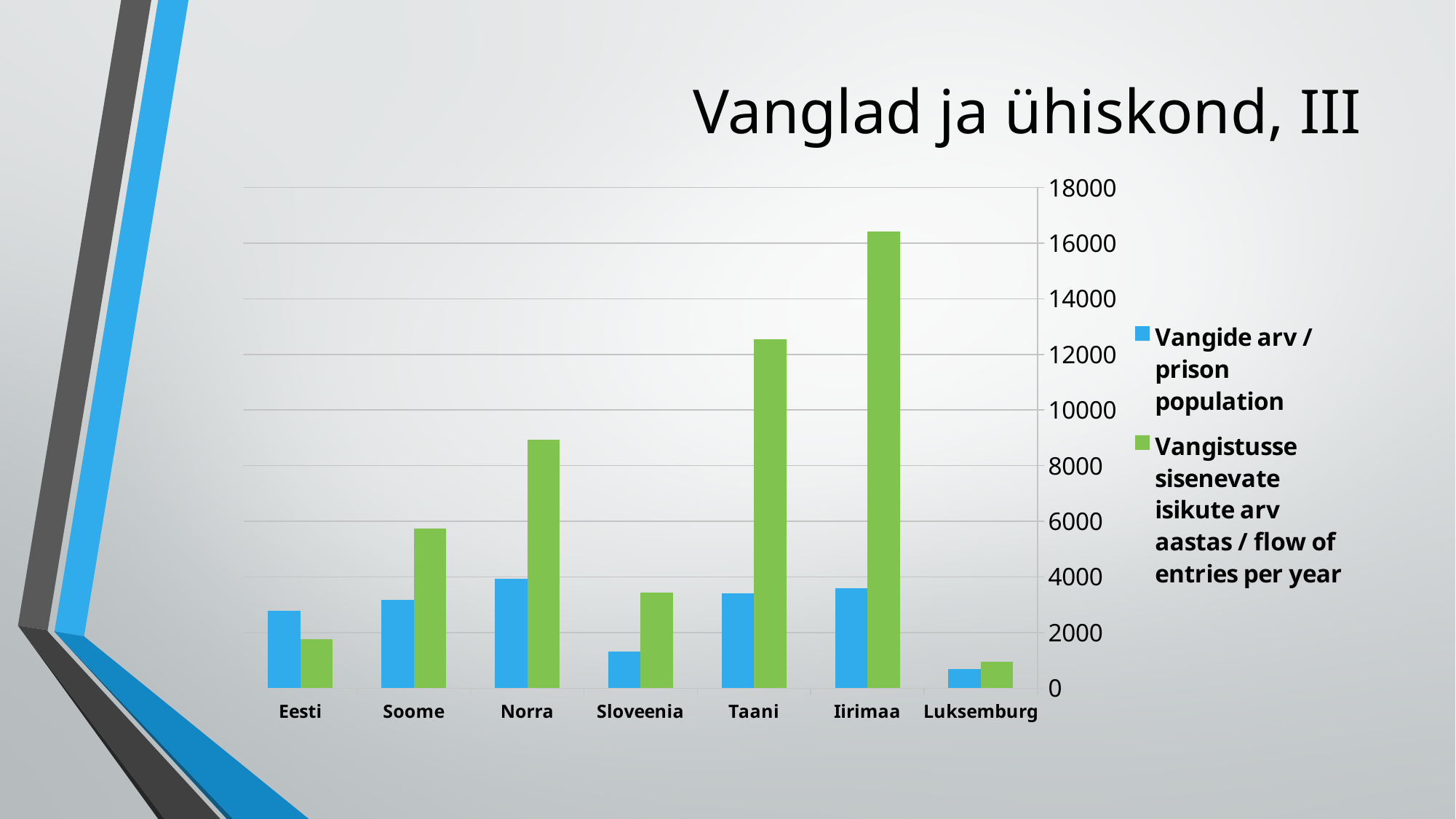
Which country has the highest value for 'Vangistusse sisenevate isikute arv aastas / flow of entries per year'? Iirimaa How many series does the chart legend list? 2 Which country has the lowest value for 'Vangistusse sisenevate isikute arv aastas / flow of entries per year'? Luksemburg Is the 'prison population' value for Sloveenia greater or less than 2000? less Is the 'flow of entries per year' value for Taani greater or less than 12000? greater Is the 'flow of entries per year' value for Iirimaa greater or less than 16000? greater What kind of chart is shown on the slide? bar chart Which series is shown in green in the chart? Vangistusse sisenevate isikute arv aastas / flow of entries per year For Eesti, which is larger: 'Vangide arv / prison population' or 'Vangistusse sisenevate isikute arv aastas / flow of entries per year'? Vangide arv / prison population Which country has the lowest value for 'Vangide arv / prison population'? Luksemburg How many countries are shown on the x axis of the chart? 7